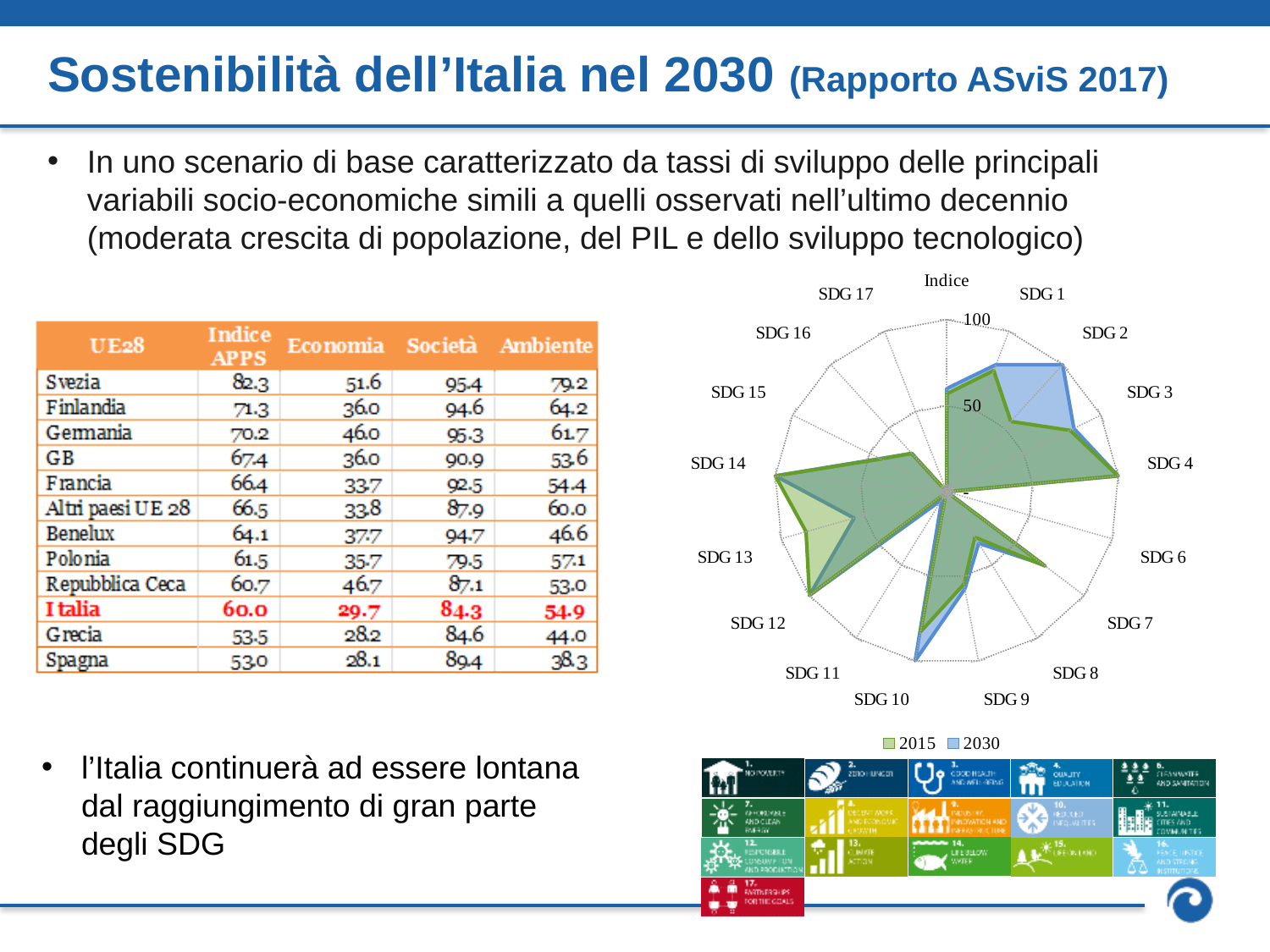
In the radar chart, is the 2015 value for SDG 14 greater or less than 50? greater In the radar chart, which has the larger 2015 value, SDG 14 or SDG 10? SDG 14 In the radar chart, is the 2015 value for SDG 17 greater or less than 50? less In the radar chart, which colour represents the 2030 series? blue What kind of chart is shown on the right side of the slide? radar chart In the radar chart, is the 2015 value for SDG 15 greater or less than 50? less What are the two series named in the legend of the radar chart? 2015 and 2030 How many series does the legend of the radar chart list? 2 In the radar chart, which has the larger 2015 value, SDG 4 or SDG 17? SDG 4